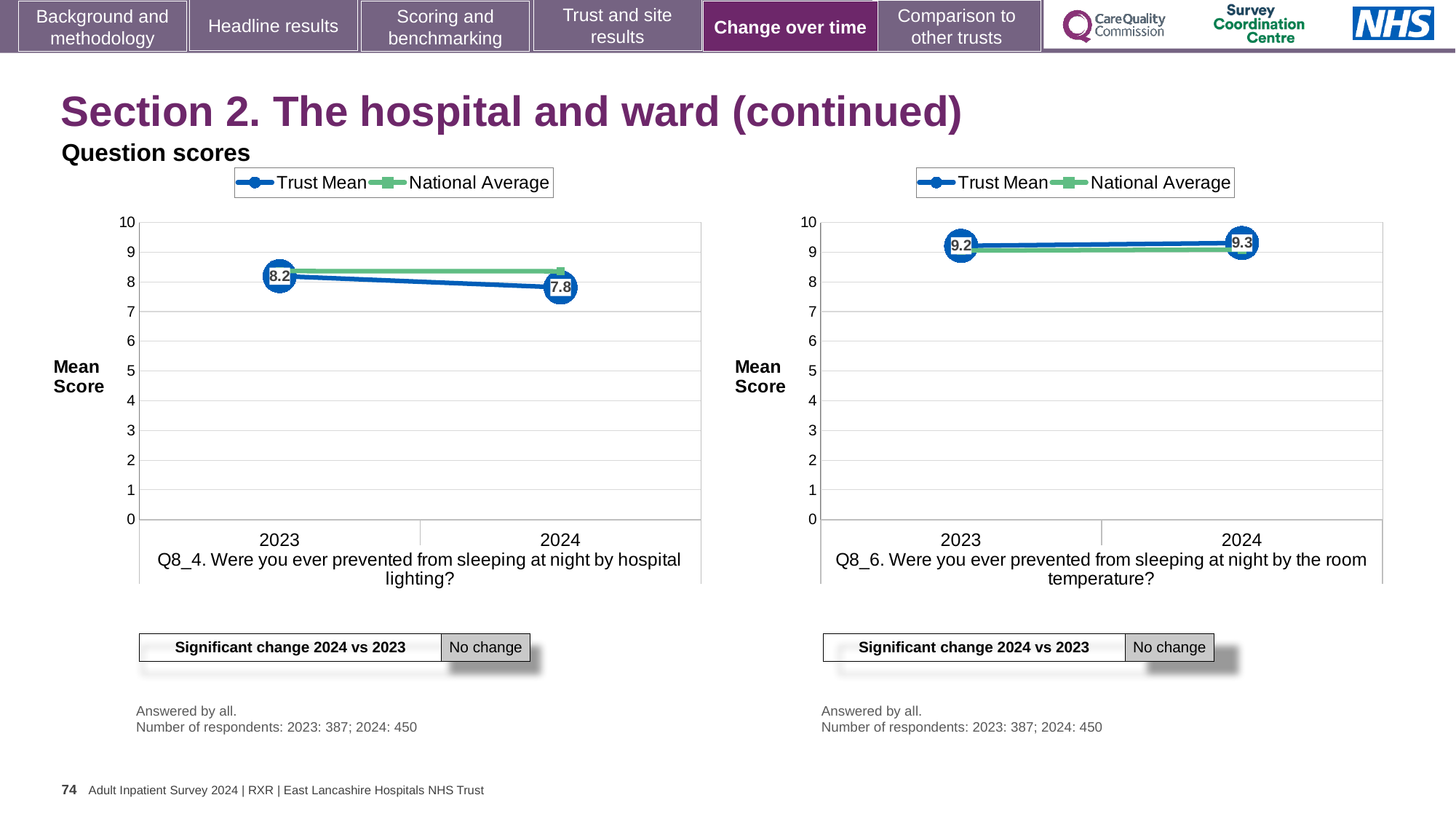
How many series does the legend of the Q8_6 chart (right) list? 2 In the Q8_4 chart (left), which year has the higher Trust Mean, 2023 or 2024? 2023 In the Q8_4 chart (left), what is the Trust Mean for 2023? 8.2 In the Q8_6 chart (right), what is the difference between the Trust Mean for 2024 and 2023? 0.1 In the Q8_4 chart (left), by how much did the Trust Mean change from 2023 to 2024? 0.4 What kind of chart is the Q8_4 chart (left)? line chart In the Q8_6 chart (right), does the Trust Mean rise or fall from 2023 to 2024? rise In the Q8_6 chart (right), what is the Trust Mean for 2023? 9.2 In the Q8_4 chart (left), does the Trust Mean rise or fall from 2023 to 2024? fall In the Q8_4 chart (left), what is the Trust Mean for 2024? 7.8 In the Q8_6 chart (right), what is the Trust Mean for 2024? 9.3 In the Q8_4 chart (left), is the National Average for 2024 greater or less than 7? greater